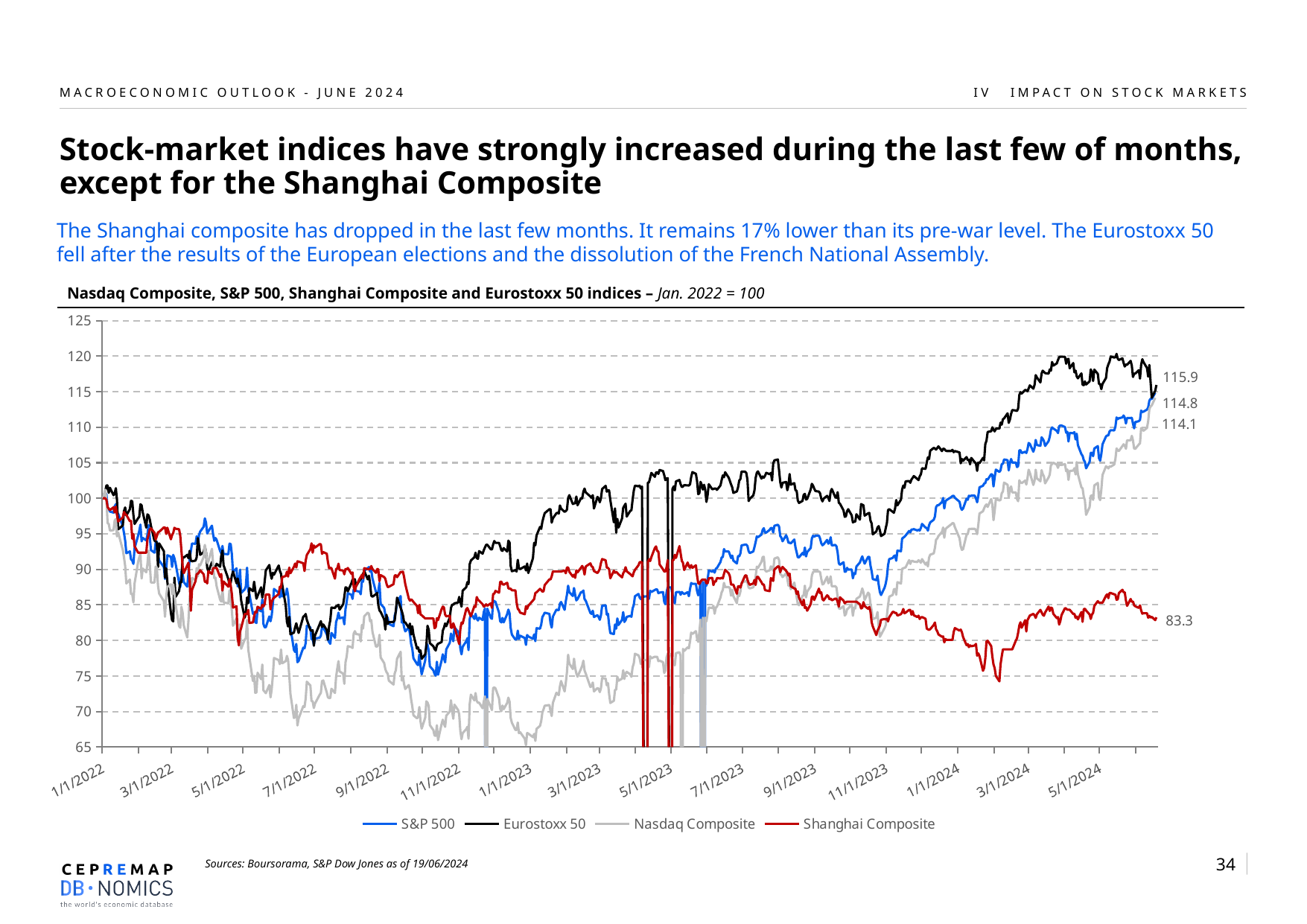
What is the highest end-of-series value labelled on the chart? 115.9 How many series does the legend list? 4 Does the S&P 500 rise or fall between 11/1/2023 and the end of the chart? rise Is the Nasdaq Composite greater or less than 70 around 11/1/2022? less At the right end of the chart, which is larger: the S&P 500 or the Shanghai Composite? S&P 500 What kind of chart is shown on the slide? line chart Is the final value of the Shanghai Composite greater or less than 90? less What colour is the Shanghai Composite line in the legend? red What base period is used for the indices, according to the chart title? Jan. 2022 = 100 Is the value of the S&P 500 at the right end of the chart greater or less than 110? greater What is the final value shown for the Shanghai Composite at the right end of the chart? 83.3 Which index has the lowest value at the right end of the chart? Shanghai Composite